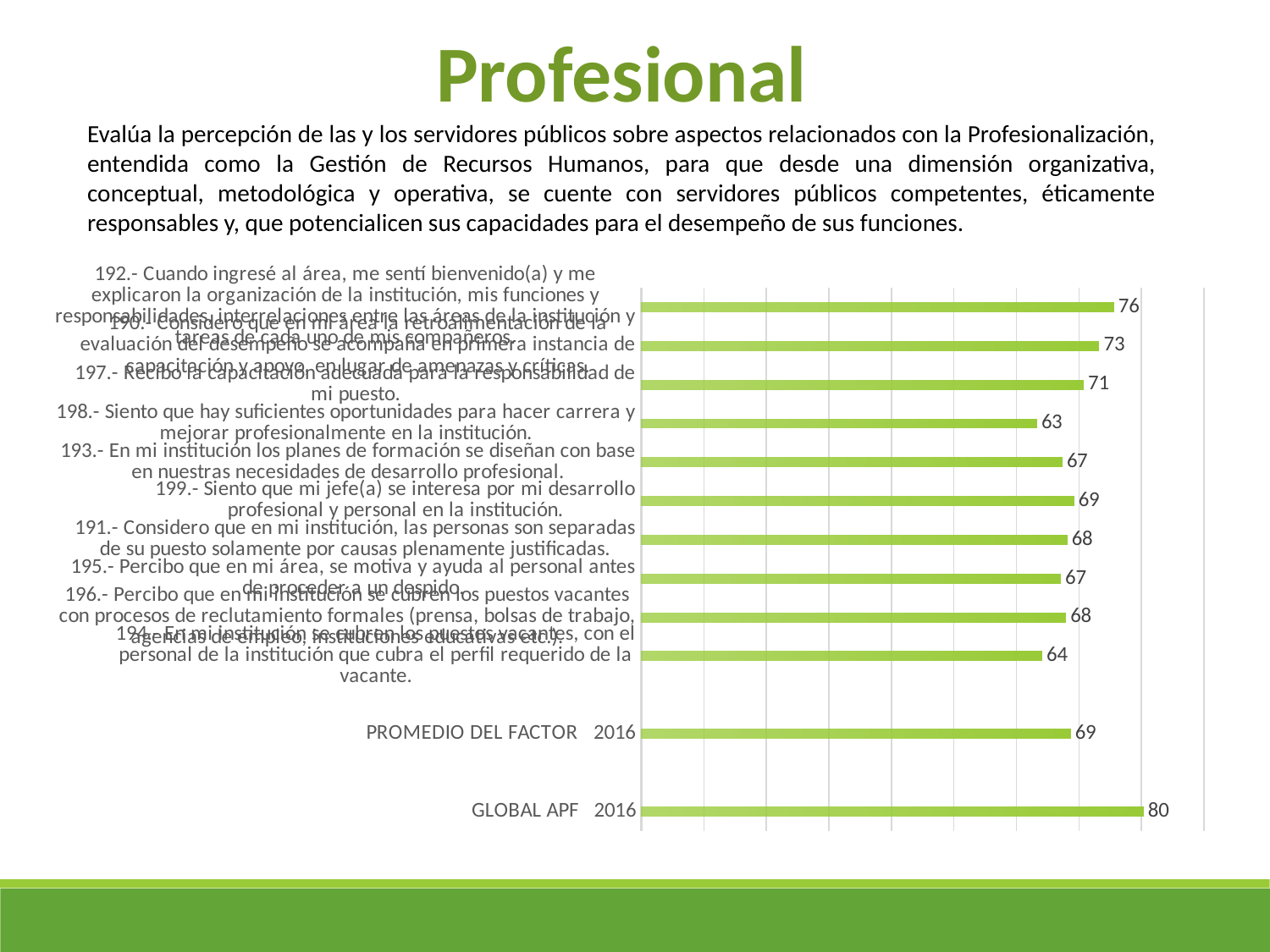
What is the value for item 199 (Siento que mi jefe(a) se interesa por mi desarrollo profesional y personal en la institución)? 69 How many bars are plotted in the chart? 12 Which category has the lowest value? 198.- Siento que hay suficientes oportunidades para hacer carrera y mejorar profesionalmente en la institución. What is the title of the slide? Profesional What is the value for PROMEDIO DEL FACTOR 2016? 69 What type of chart is shown on the slide? bar chart What is the value for GLOBAL APF 2016? 80 What is the difference between GLOBAL APF 2016 and PROMEDIO DEL FACTOR 2016? 11 What is the value for item 198 (Siento que hay suficientes oportunidades para hacer carrera y mejorar profesionalmente en la institución)? 63 Which category has the highest value? GLOBAL APF 2016 What is the value for item 192 (Cuando ingresé al área, me sentí bienvenido(a)...)? 76 Which is larger, the value for item 192 or the value for item 198? item 192